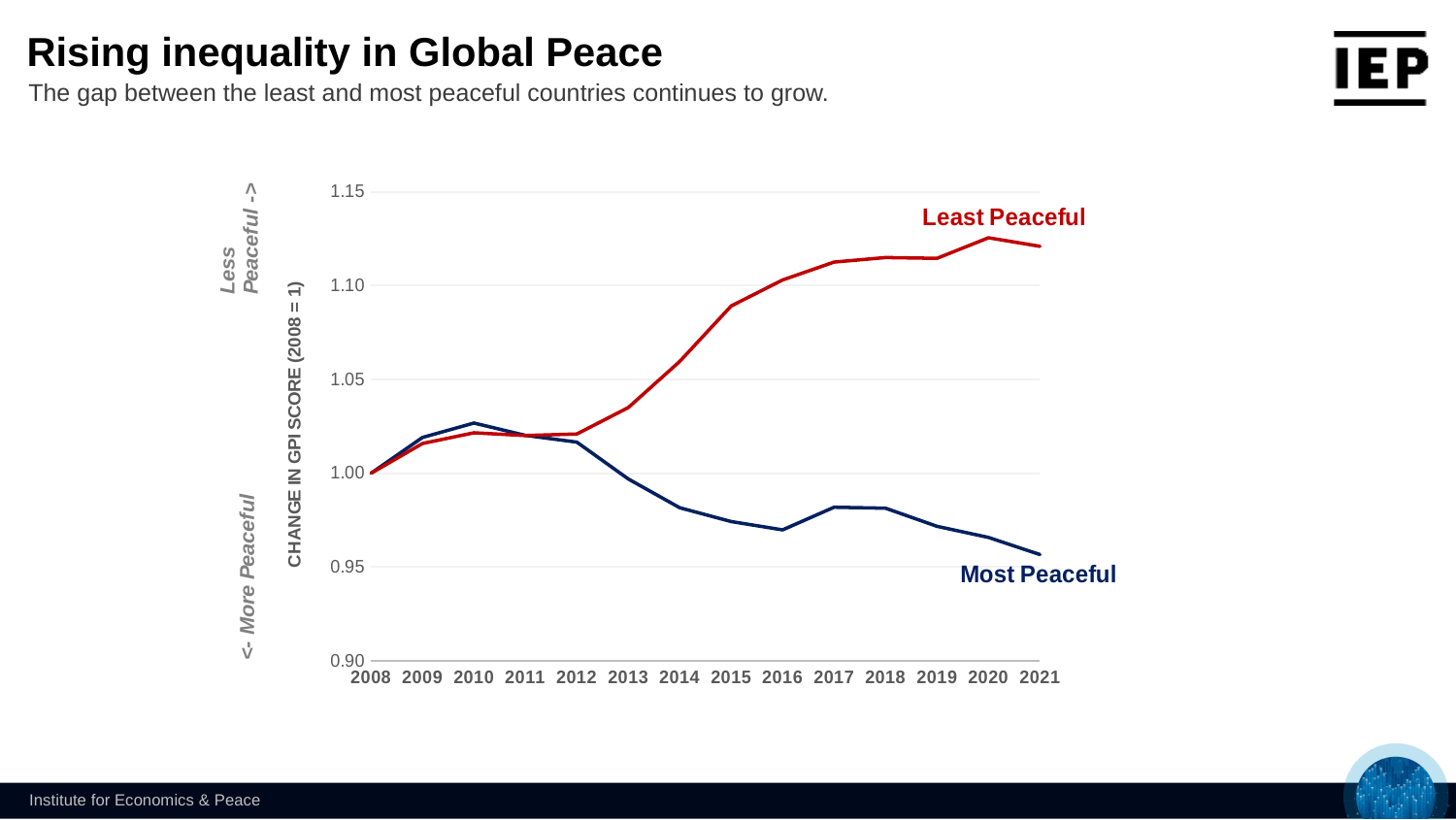
What is the value of both series in 2008? 1.00 Is the value for Least Peaceful in 2021 greater or less than 1.10? greater Does the Least Peaceful series rise or fall between 2012 and 2021? Rise What type of chart is shown on the slide? Line chart What is the title of the chart's y axis? CHANGE IN GPI SCORE (2008 = 1) Which series has the higher value in 2021, Least Peaceful or Most Peaceful? Least Peaceful In which year does the Most Peaceful series reach its lowest value? 2021 How many years are shown along the x axis of the chart? 14 Is the value for Least Peaceful in 2015 greater or less than 1.05? greater Is the value for Most Peaceful in 2021 greater or less than 1.00? less How many series are plotted on the chart? 2 In which year does the Least Peaceful series reach its highest value? 2020